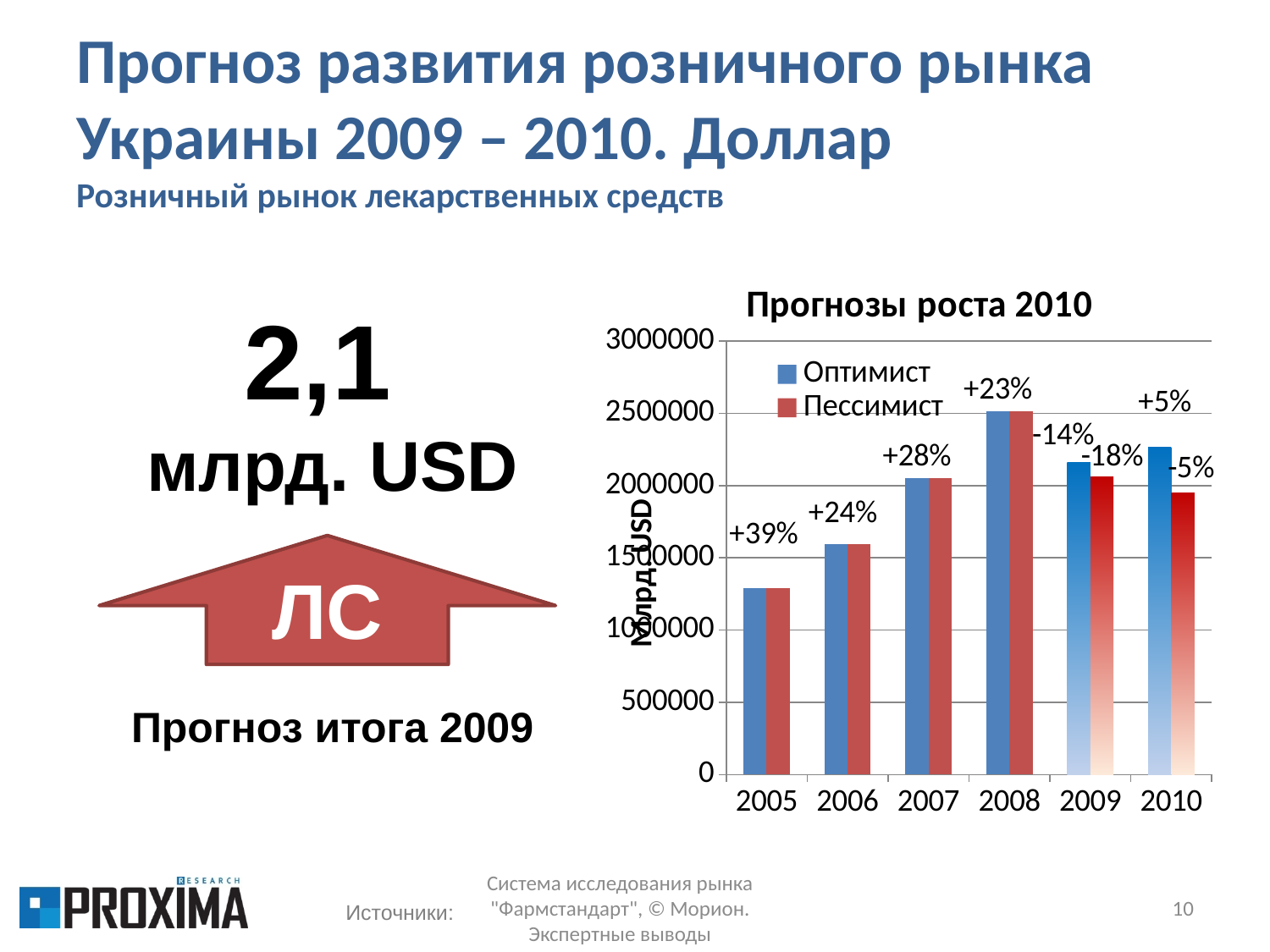
In the "Прогнозы роста 2010" chart, which year has the lowest bars? 2005 In the "Прогнозы роста 2010" chart, is the Оптимист value for 2010 greater or less than 2000000? greater What kind of chart is "Прогнозы роста 2010"? bar chart In the "Прогнозы роста 2010" chart, what growth percentage is labelled for the Пессимист series in 2010? -5% In the "Прогнозы роста 2010" chart, is the value for 2005 greater or less than 1500000? less In the "Прогнозы роста 2010" chart, what growth percentage is labelled for 2007? +28% In the "Прогнозы роста 2010" chart, which series has the larger value in 2010, Оптимист or Пессимист? Оптимист How many series does the legend of the "Прогнозы роста 2010" chart list? 2 How many years are shown on the x axis of the "Прогнозы роста 2010" chart? 6 In the "Прогнозы роста 2010" chart, what growth percentage is labelled for 2005? +39% In the "Прогнозы роста 2010" chart, what growth percentage is labelled for the Оптимист series in 2009? -14% In the "Прогнозы роста 2010" chart, which year has the highest bars? 2008